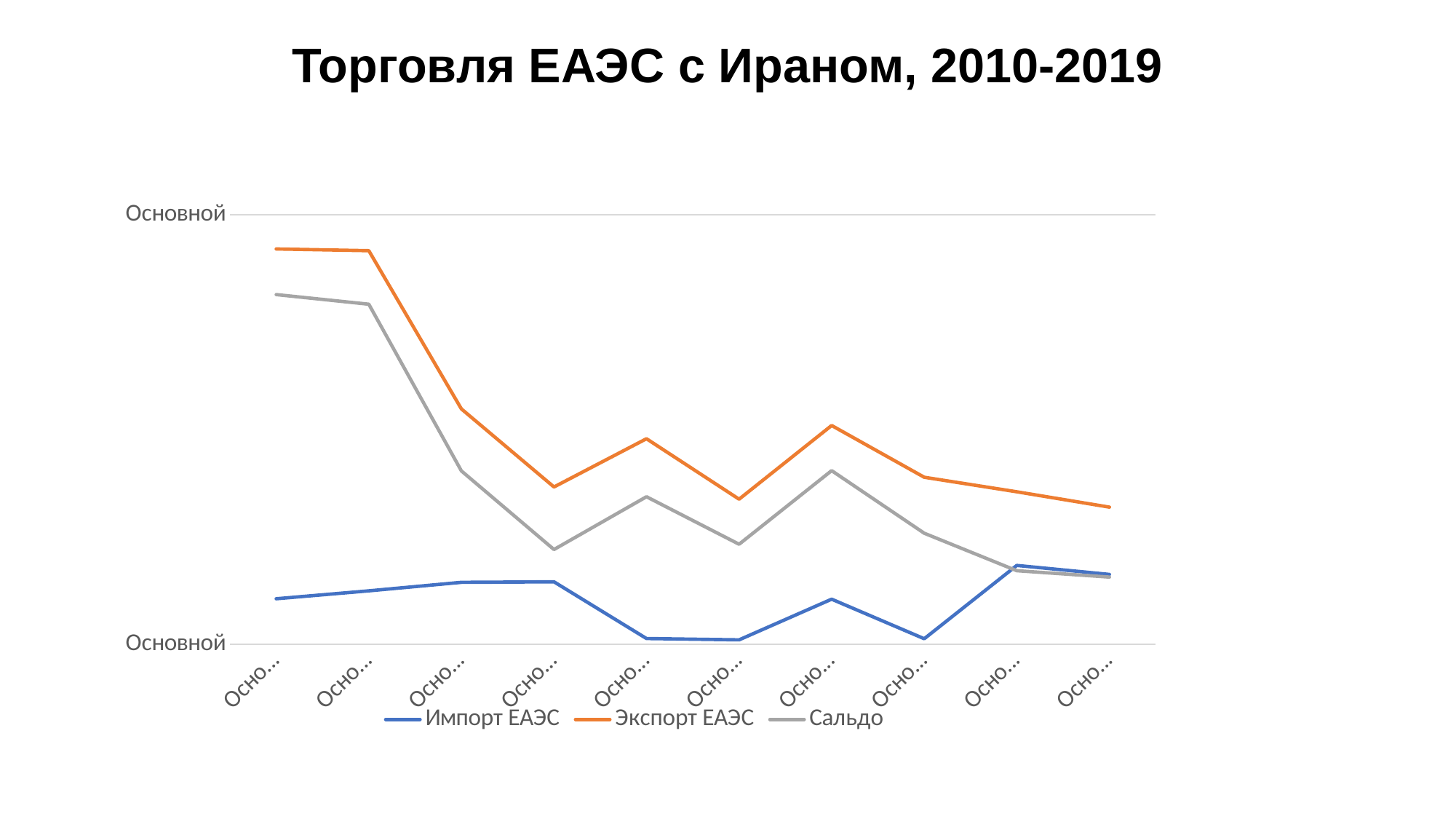
Does the Импорт ЕАЭС line rise or fall between the eighth and ninth points from the left? rise At the leftmost point, which series has the highest value? Экспорт ЕАЭС What is the title of the chart? Торговля ЕАЭС с Ираном, 2010-2019 What kind of chart is shown on the slide? line chart Which series is drawn in orange? Экспорт ЕАЭС Does the Сальдо line rise or fall overall from the leftmost point to the rightmost point? fall At the leftmost point, which is larger: Экспорт ЕАЭС or Импорт ЕАЭС? Экспорт ЕАЭС At the fourth point from the left, which is larger: Сальдо or Импорт ЕАЭС? Сальдо Does the Экспорт ЕАЭС line rise or fall overall from the leftmost point to the rightmost point? fall How many series does the legend list? 3 At the leftmost point, which series has the lowest value? Импорт ЕАЭС How many data points does each line have along the x axis? 10